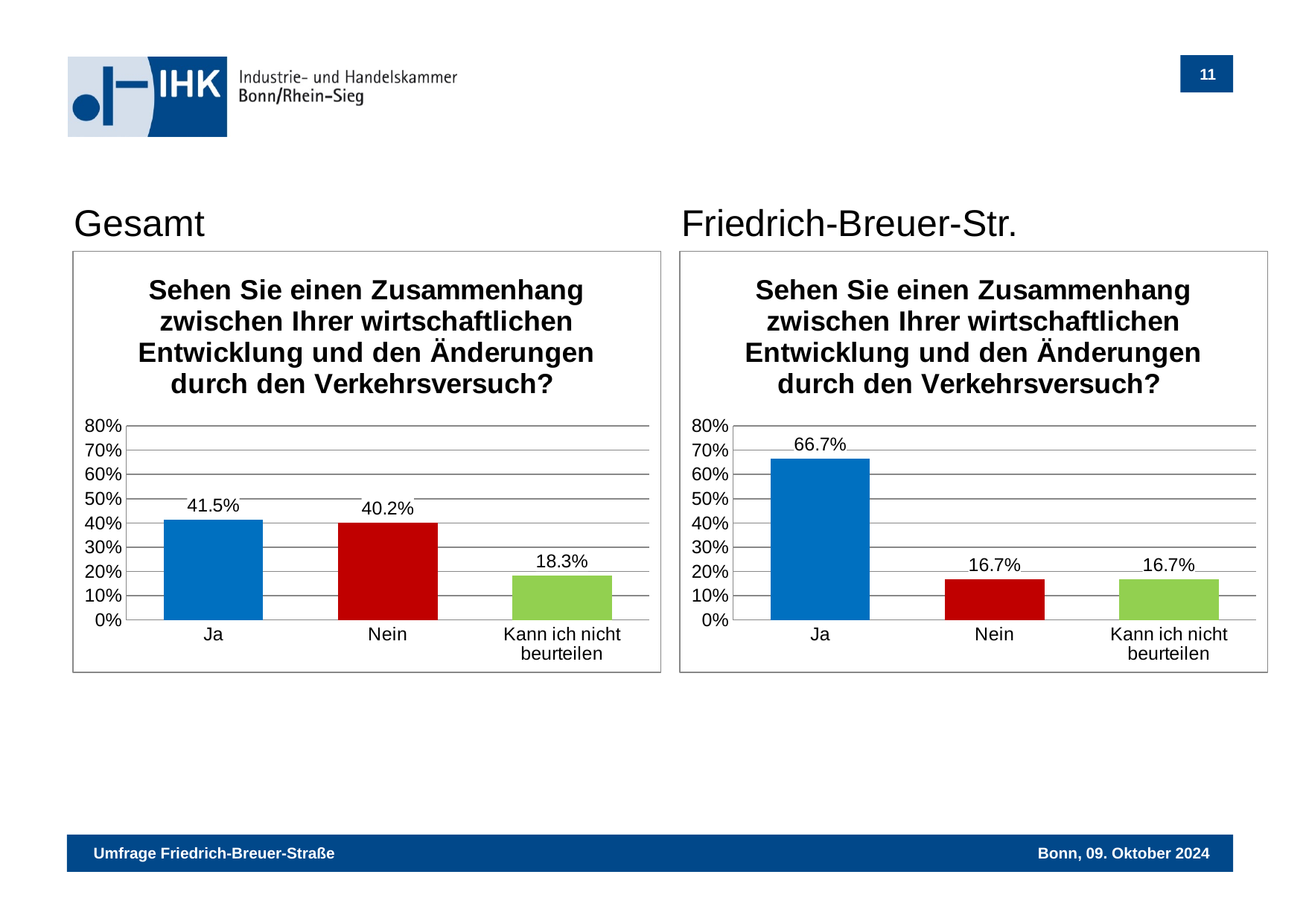
In the "Gesamt" chart, is the value for "Nein" greater or less than 50%? less Is the value for "Ja" larger in the "Gesamt" chart or in the "Friedrich-Breuer-Str." chart? Friedrich-Breuer-Str. In the "Friedrich-Breuer-Str." chart, what is the value for "Ja"? 66.7% What kind of chart is the "Gesamt" chart? bar chart In the "Friedrich-Breuer-Str." chart, which category has the highest value? Ja In the "Friedrich-Breuer-Str." chart, what is the difference between the values for "Ja" and "Nein"? 50.0% In the "Friedrich-Breuer-Str." chart, what is the value for "Nein"? 16.7% In the "Gesamt" chart, what is the value for "Ja"? 41.5% How many categories are shown in the "Friedrich-Breuer-Str." chart? 3 In the "Gesamt" chart, what is the difference between the values for "Ja" and "Nein"? 1.3% In the "Gesamt" chart, which category has the lowest value? Kann ich nicht beurteilen In the "Gesamt" chart, what is the value for "Kann ich nicht beurteilen"? 18.3%